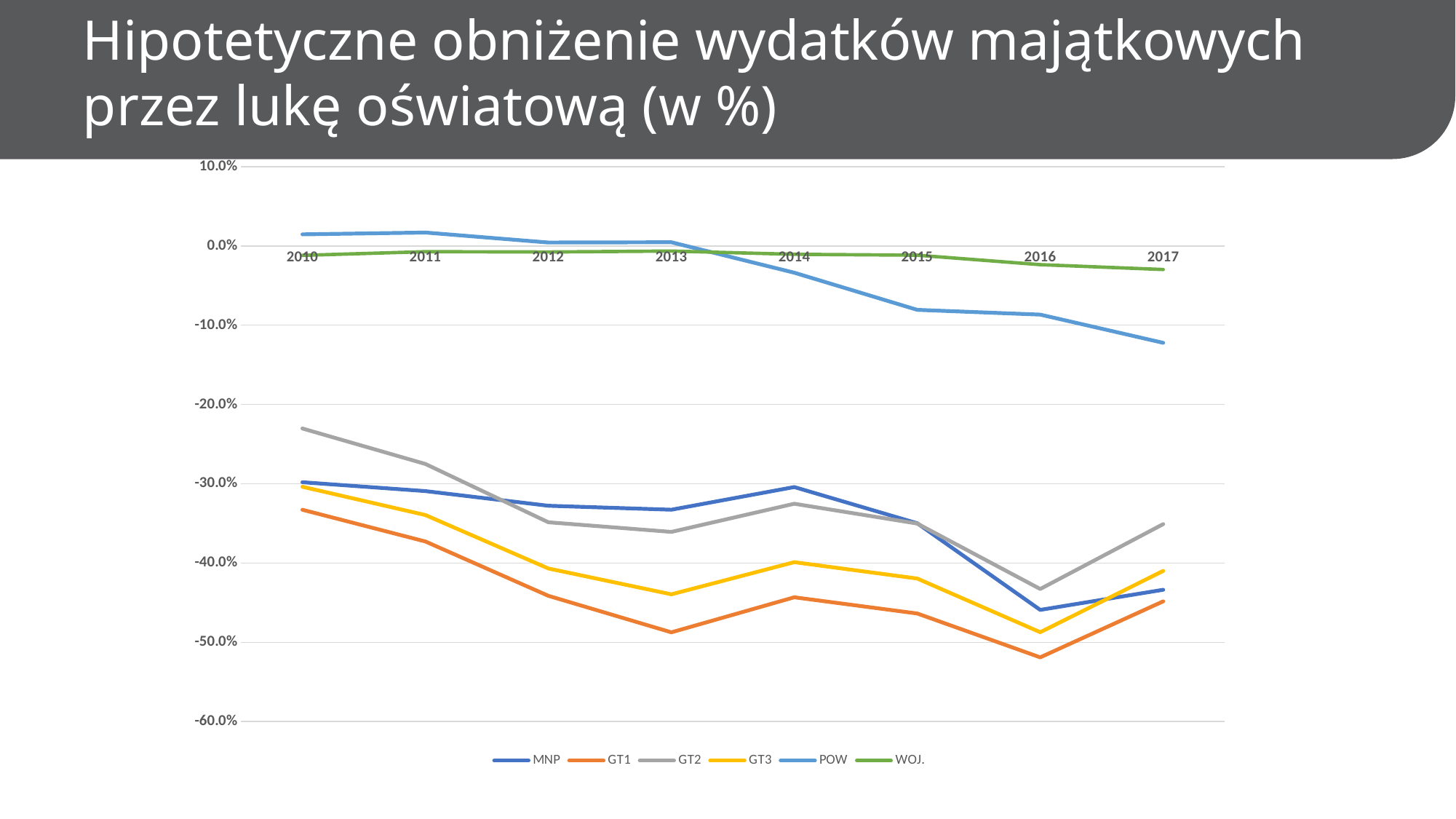
Which series has the lowest value in 2016? GT1 How many years are shown along the x axis? 8 Is the value for GT2 in 2010 greater or less than -30.0%? greater Does the POW line rise or fall from 2010 to 2017? fall What is the title of the slide? Hipotetyczne obniżenie wydatków majątkowych przez lukę oświatową (w %) Is the value for POW in 2017 greater or less than -10.0%? less What kind of chart is shown on the slide? line chart Is the value for GT1 in 2016 greater or less than -50.0%? less In 2017, which is larger: the value for GT2 or the value for MNP? GT2 Which series has the highest value in 2010? POW In which year does GT3 reach its lowest value? 2016 How many series does the legend list? 6